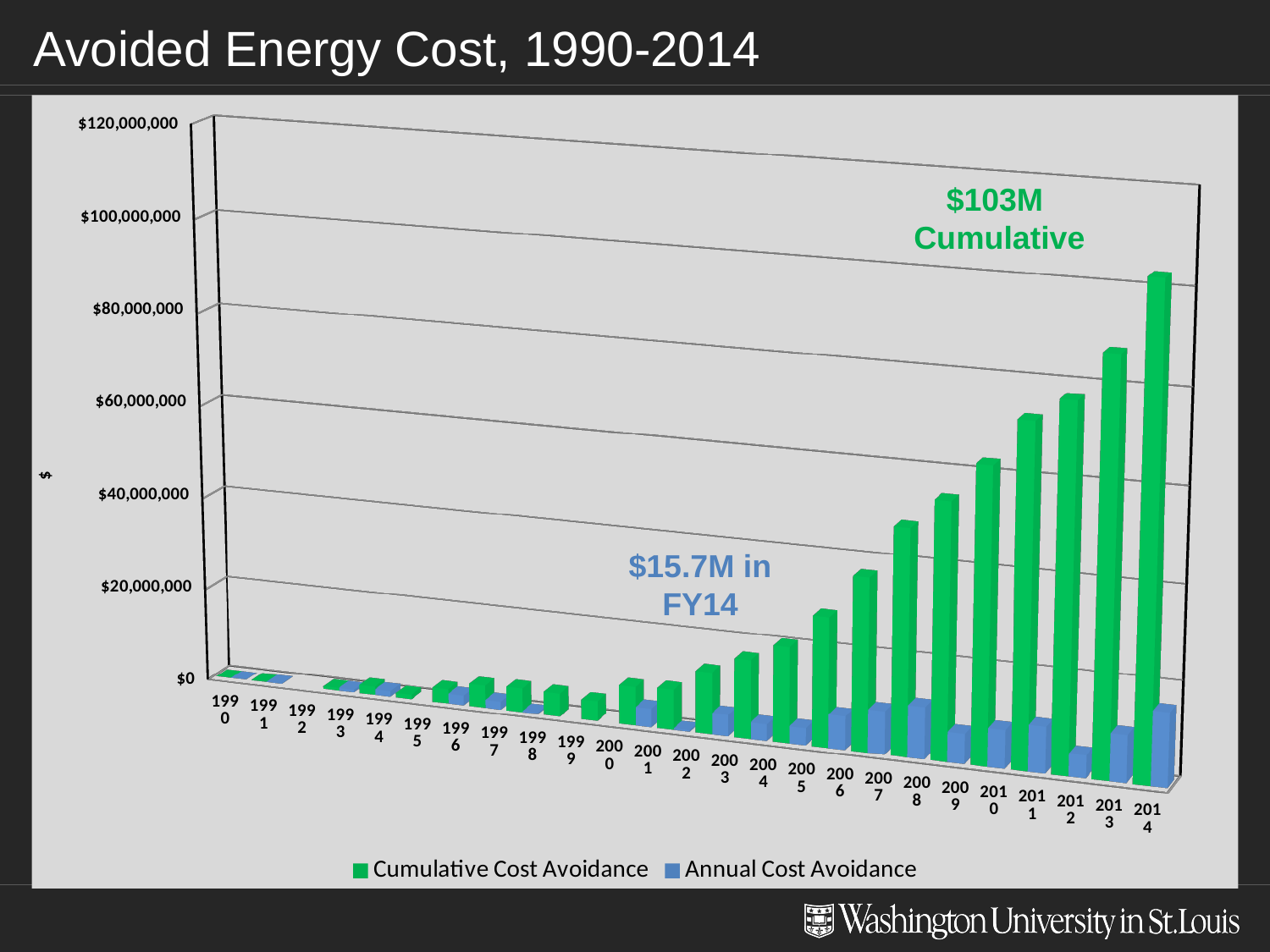
What type of chart is shown on the slide? bar chart What is the title of the chart? Avoided Energy Cost, 1990-2014 What are the two series named in the legend? Cumulative Cost Avoidance and Annual Cost Avoidance Is the Cumulative Cost Avoidance for 2014 greater or less than $60,000,000? greater Which is larger in 2014, the Cumulative Cost Avoidance or the Annual Cost Avoidance? Cumulative Cost Avoidance How many series does the legend list? 2 What annual cost avoidance value is called out for FY14? $15.7M Is the Cumulative Cost Avoidance for 2003 greater or less than $20,000,000? less Which year has the highest Cumulative Cost Avoidance? 2014 Does the Cumulative Cost Avoidance rise or fall from 1990 to 2014? rise What cumulative cost avoidance value is called out on the chart? $103M How many years are shown along the x axis? 25